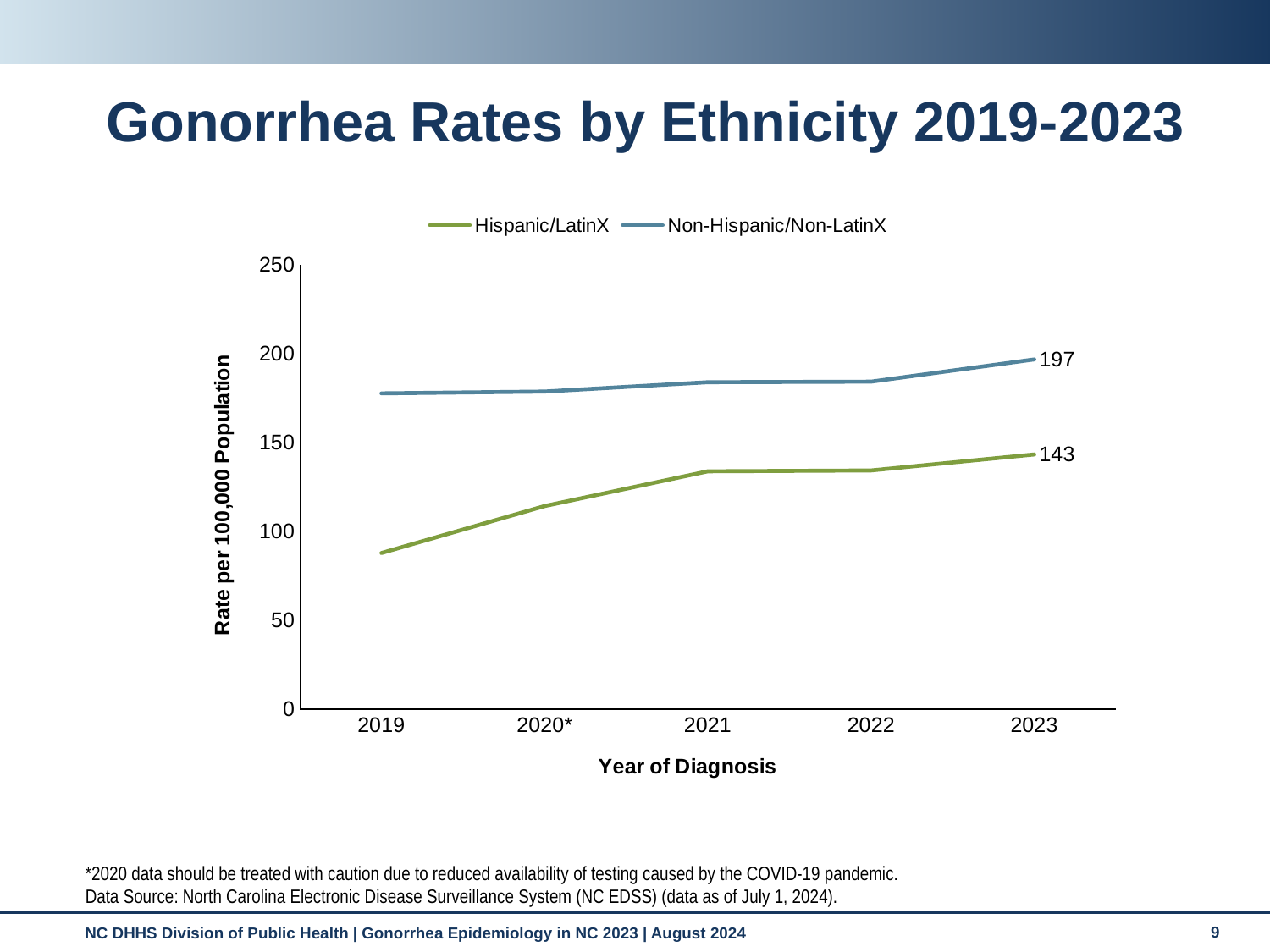
How many series does the legend list? 2 What is the difference between the Non-Hispanic/Non-LatinX and Hispanic/LatinX rates in 2023? 54 Which series has the higher rate in 2023, Hispanic/LatinX or Non-Hispanic/Non-LatinX? Non-Hispanic/Non-LatinX What kind of chart is shown on the slide? line chart How many years are shown on the x axis? 5 Does the Hispanic/LatinX rate rise or fall from 2019 to 2023? rise Is the Hispanic/LatinX rate in 2019 greater or less than 100? less What is the gonorrhea rate for Hispanic/LatinX in 2023? 143 Is the Hispanic/LatinX rate in 2021 greater or less than 150? less What is the gonorrhea rate for Non-Hispanic/Non-LatinX in 2023? 197 Is the Non-Hispanic/Non-LatinX rate in 2019 greater or less than 150? greater What is the title of the chart? Gonorrhea Rates by Ethnicity 2019-2023